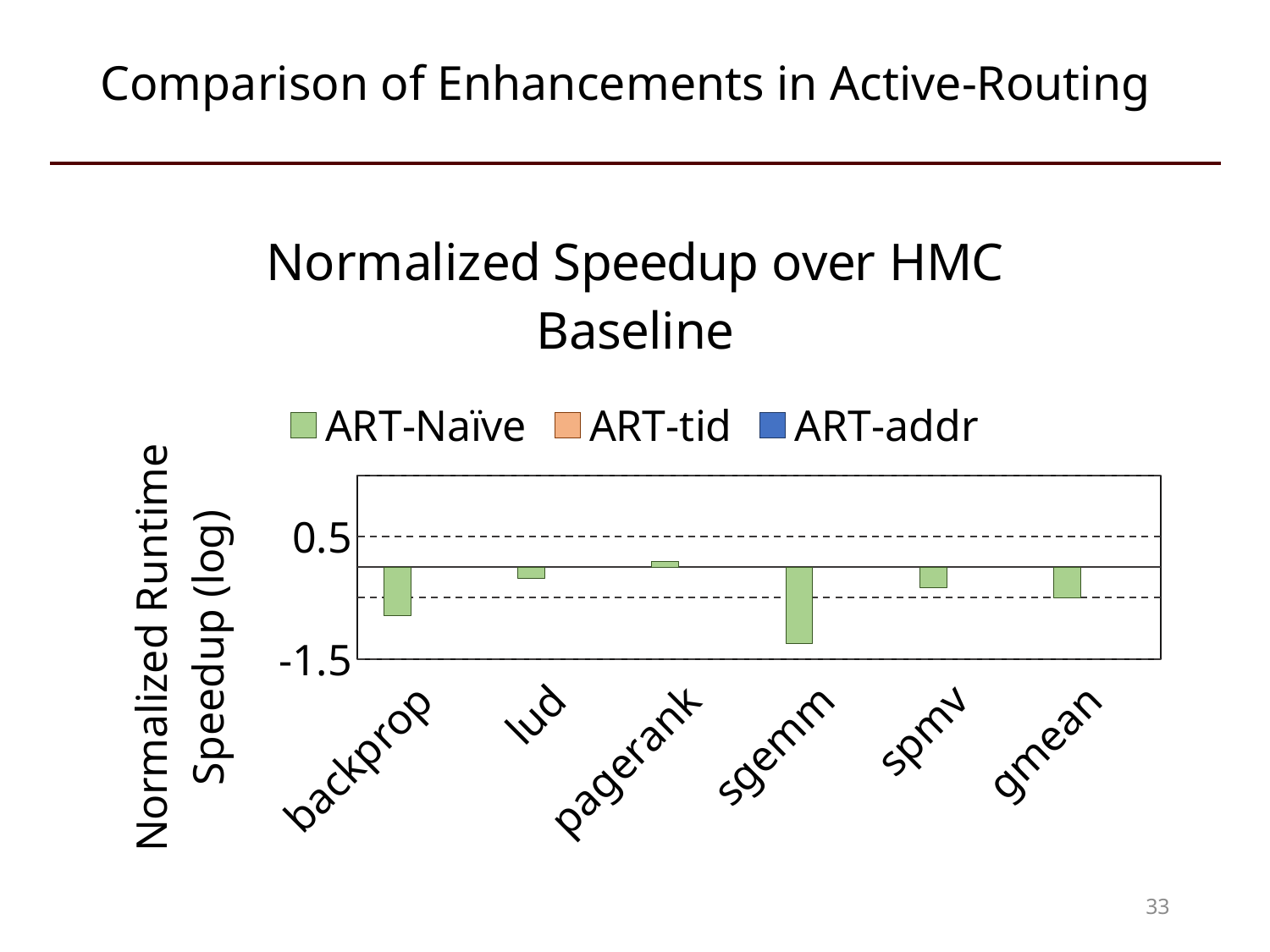
What is the title of the chart? Normalized Speedup over HMC Baseline What is the label of the chart's y axis? Normalized Runtime Speedup (log) How many categories are shown along the x axis of the chart? 6 Which has the larger ART-Naïve value, sgemm or spmv? spmv Is the ART-Naïve value for backprop greater or less than 0.5? less Which category has the highest ART-Naïve value? pagerank Which category has the lowest ART-Naïve value? sgemm Is the ART-Naïve value for pagerank greater or less than 0.5? less How many series does the chart's legend list? 3 Is the ART-Naïve value for gmean greater or less than -1.5? greater What kind of chart is shown on the slide? bar chart Which has the larger ART-Naïve value, backprop or lud? lud